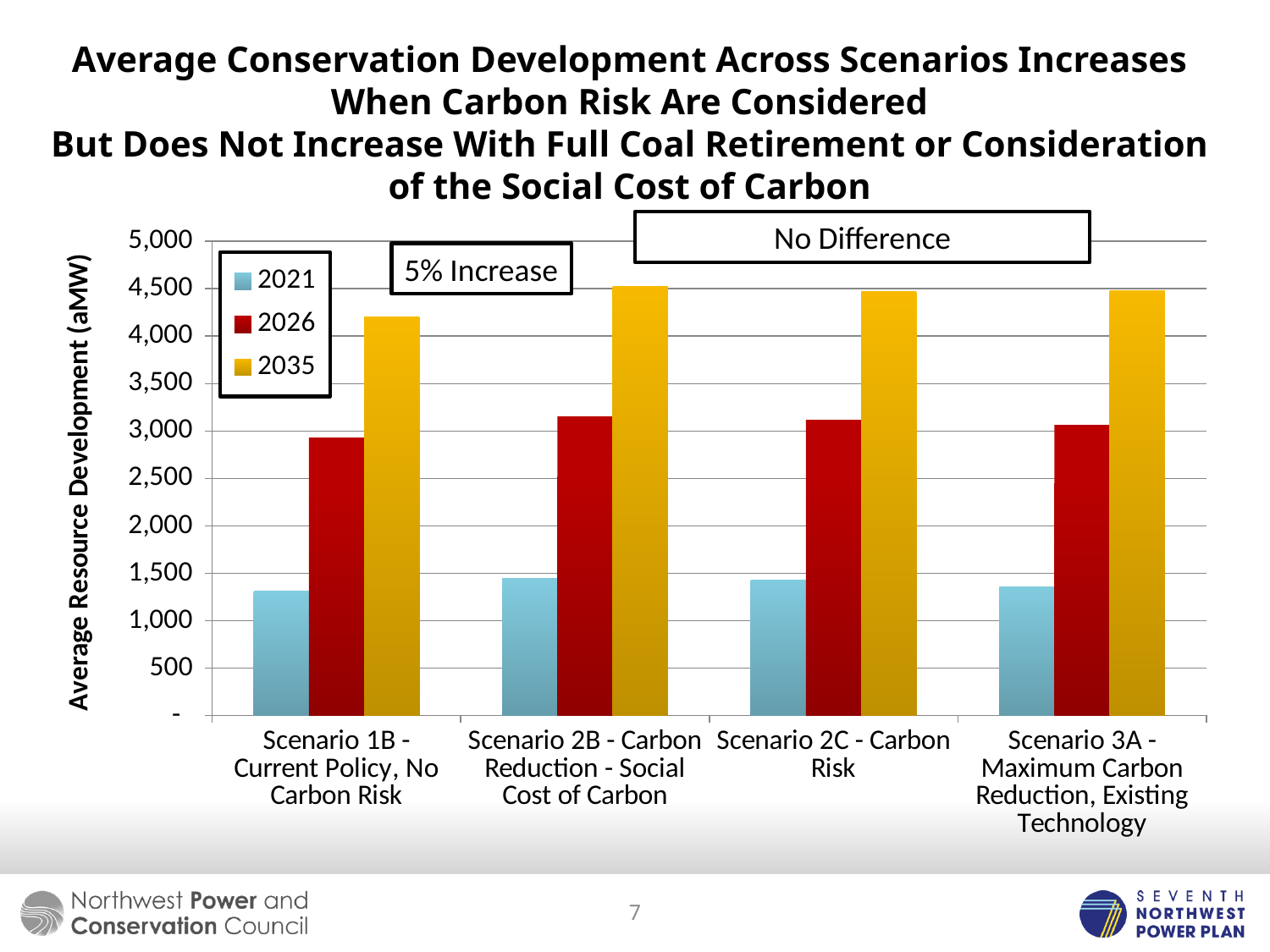
Is the 2021 value for Scenario 1B - Current Policy, No Carbon Risk greater or less than 1,500? less Which scenario has the lowest 2035 value? Scenario 1B - Current Policy, No Carbon Risk Is the 2035 value for Scenario 2C - Carbon Risk greater or less than 4,000? greater Within each scenario, do the values rise or fall from 2021 to 2035? rise How many series does the legend list? 3 For Scenario 3A - Maximum Carbon Reduction, Existing Technology, which is larger: the 2026 value or the 2035 value? 2035 What kind of chart is shown on the slide? bar chart Is the 2035 value for Scenario 1B - Current Policy, No Carbon Risk greater or less than 4,000? greater How many scenarios are shown on the x axis? 4 What is the label of the vertical axis? Average Resource Development (aMW) Which years are listed in the legend? 2021, 2026, 2035